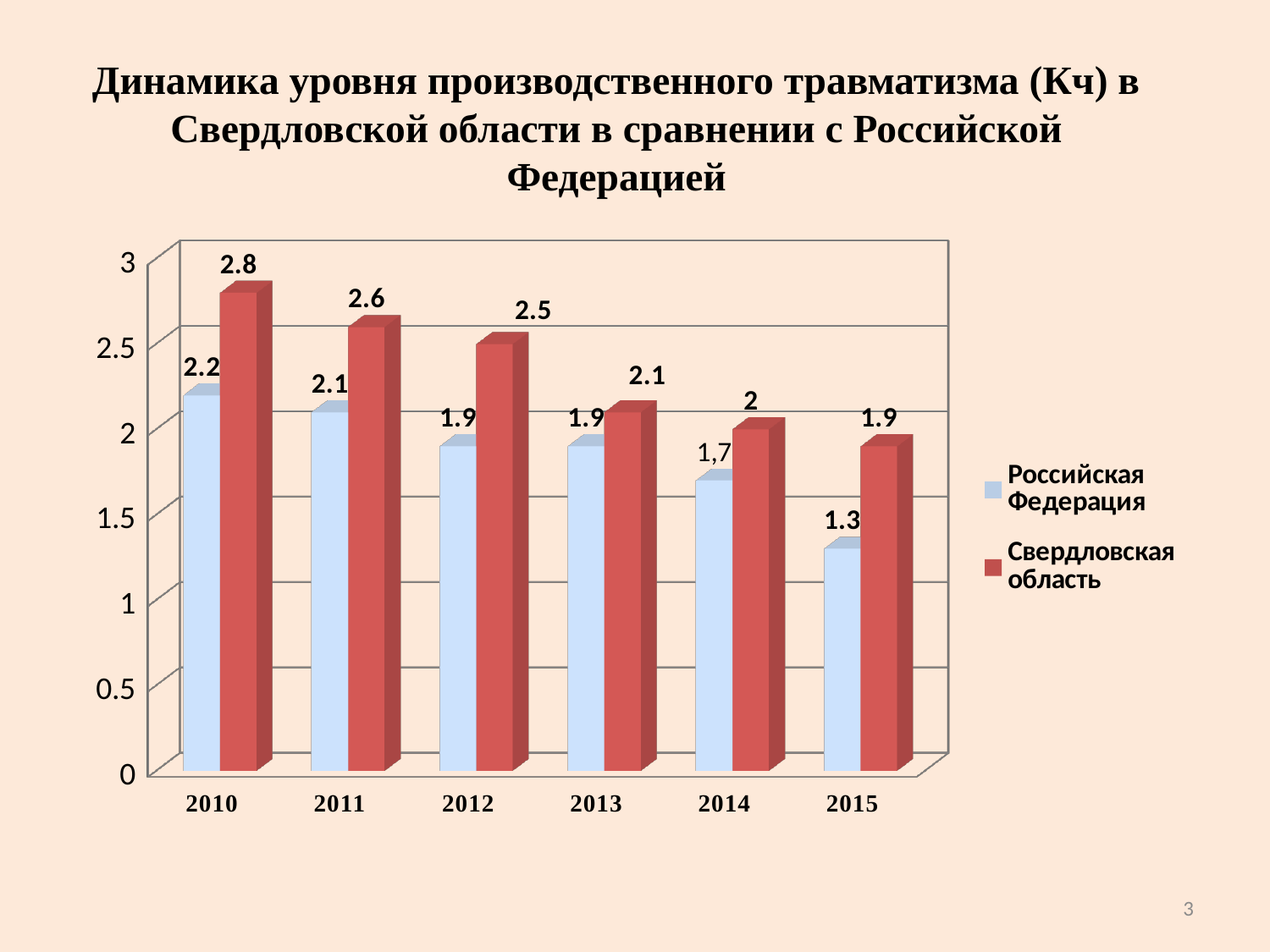
What is the value for Российская Федерация in 2014? 1,7 What kind of chart is shown on the slide? bar chart What is the value for Свердловская область in 2015? 1.9 In which year is the value for Российская Федерация lowest? 2015 How many series does the legend list? 2 What is the value for Свердловская область in 2012? 2.5 In which year is the value for Свердловская область highest? 2010 What is the value for Российская Федерация in 2010? 2.2 What is the difference between Свердловская область and Российская Федерация in 2010? 0.6 Which is larger in 2013: Российская Федерация or Свердловская область? Свердловская область Do the values for Свердловская область rise or fall from 2010 to 2015? fall How many years are shown on the x axis? 6